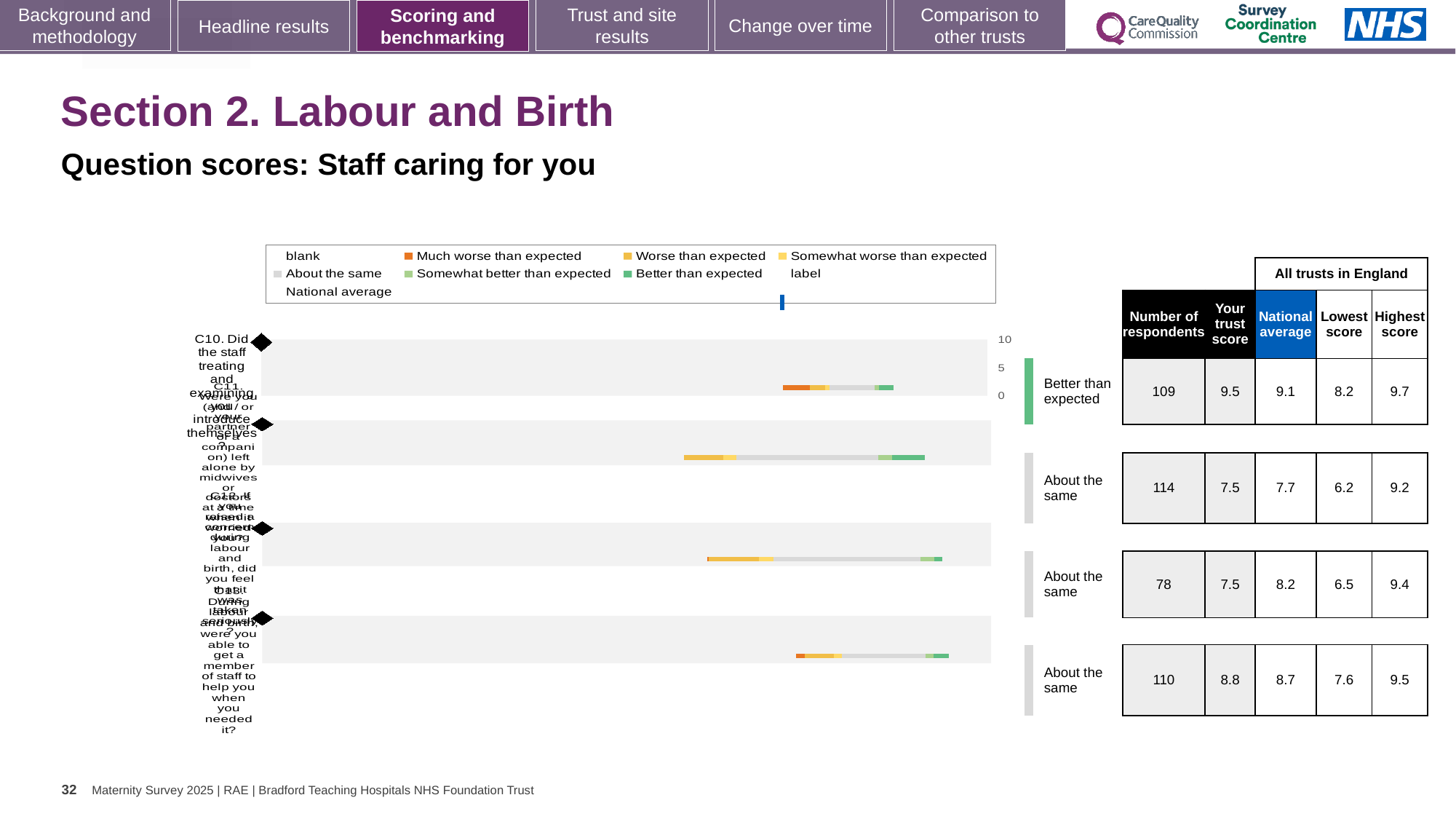
Which question row has the fewest respondents? the third row (78) For the fourth (bottom) question row, is 'Your trust score' larger or smaller than the national average? larger What is the difference between 'Your trust score' and the national average for the first (top) question row? 0.4 What kind of chart is shown on the slide? bar chart In the chart legend, what colour represents 'Much worse than expected'? orange What is the benchmark rating shown for the first (top) question row? Better than expected How many question rows are plotted in the chart? 4 What is the number of respondents for the first (top) question row? 109 Which question row has the highest 'Your trust score'? the first row (9.5) What is the highest score across all trusts in England for the third question row? 9.4 What is the 'Your trust score' for the first (top) question row? 9.5 What is the national average for the second question row? 7.7